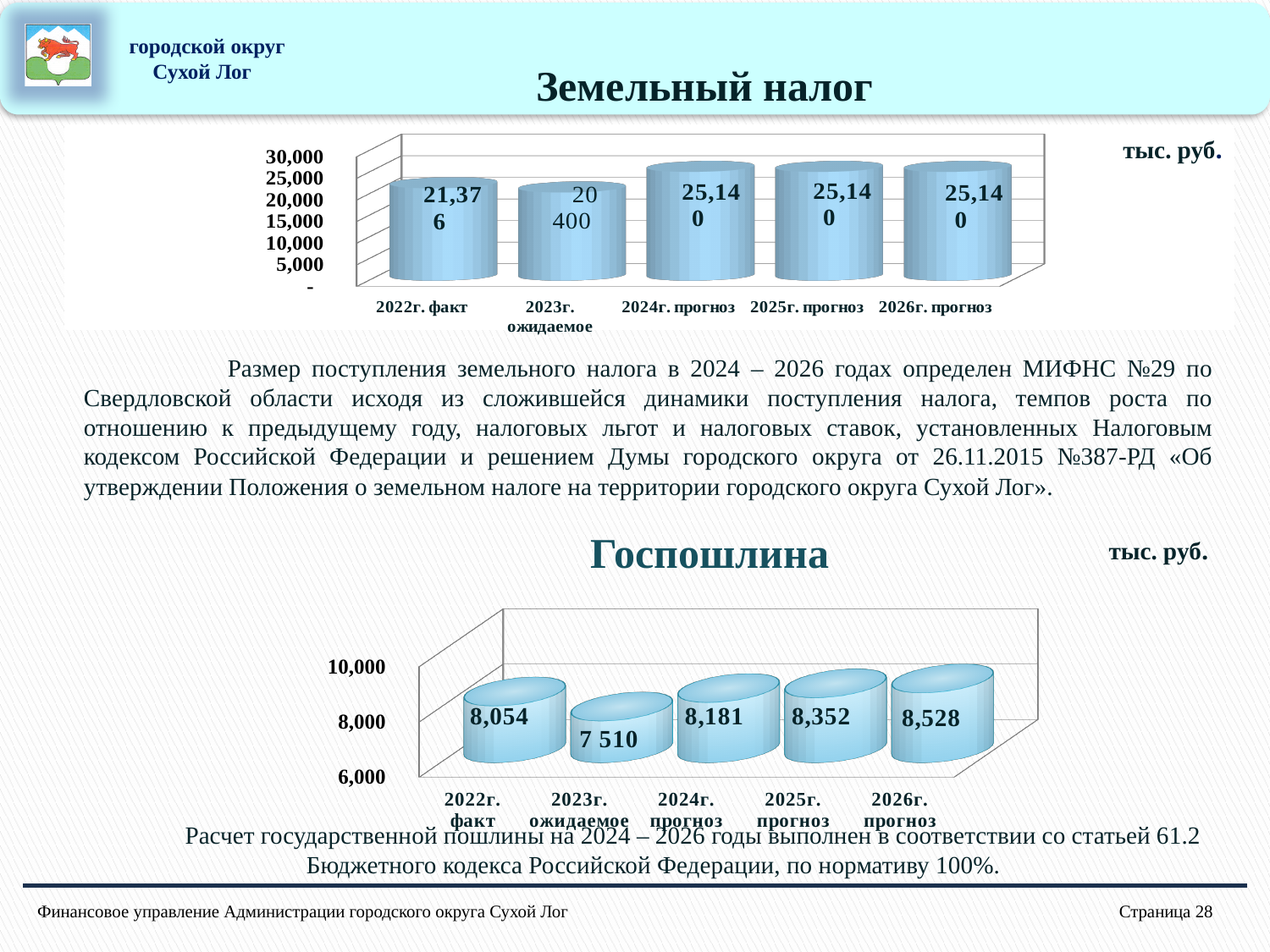
On the 'Госпошлина' chart, which is larger: the value for 2022г. факт or the value for 2024г. прогноз? 2024г. прогноз On the 'Земельный налог' chart, what is the value for 2022г. факт? 21,376 On the 'Госпошлина' chart, what is the value for 2023г. ожидаемое? 7 510 On the 'Земельный налог' chart, which category has the lowest value? 2023г. ожидаемое On the 'Госпошлина' chart, what is the difference between the 2025г. прогноз value and the 2024г. прогноз value? 171 On the 'Земельный налог' chart, what is the value for 2025г. прогноз? 25,140 What kind of chart is the 'Госпошлина' chart? Bar chart On the 'Госпошлина' chart, which category has the highest value? 2026г. прогноз On the 'Земельный налог' chart, what is the difference between the 2024г. прогноз value and the 2022г. факт value? 3,764 On the 'Госпошлина' chart, what is the value for 2026г. прогноз? 8,528 On the 'Земельный налог' chart, how many categories are plotted? 5 On the 'Земельный налог' chart, what is the value for 2023г. ожидаемое? 20 400